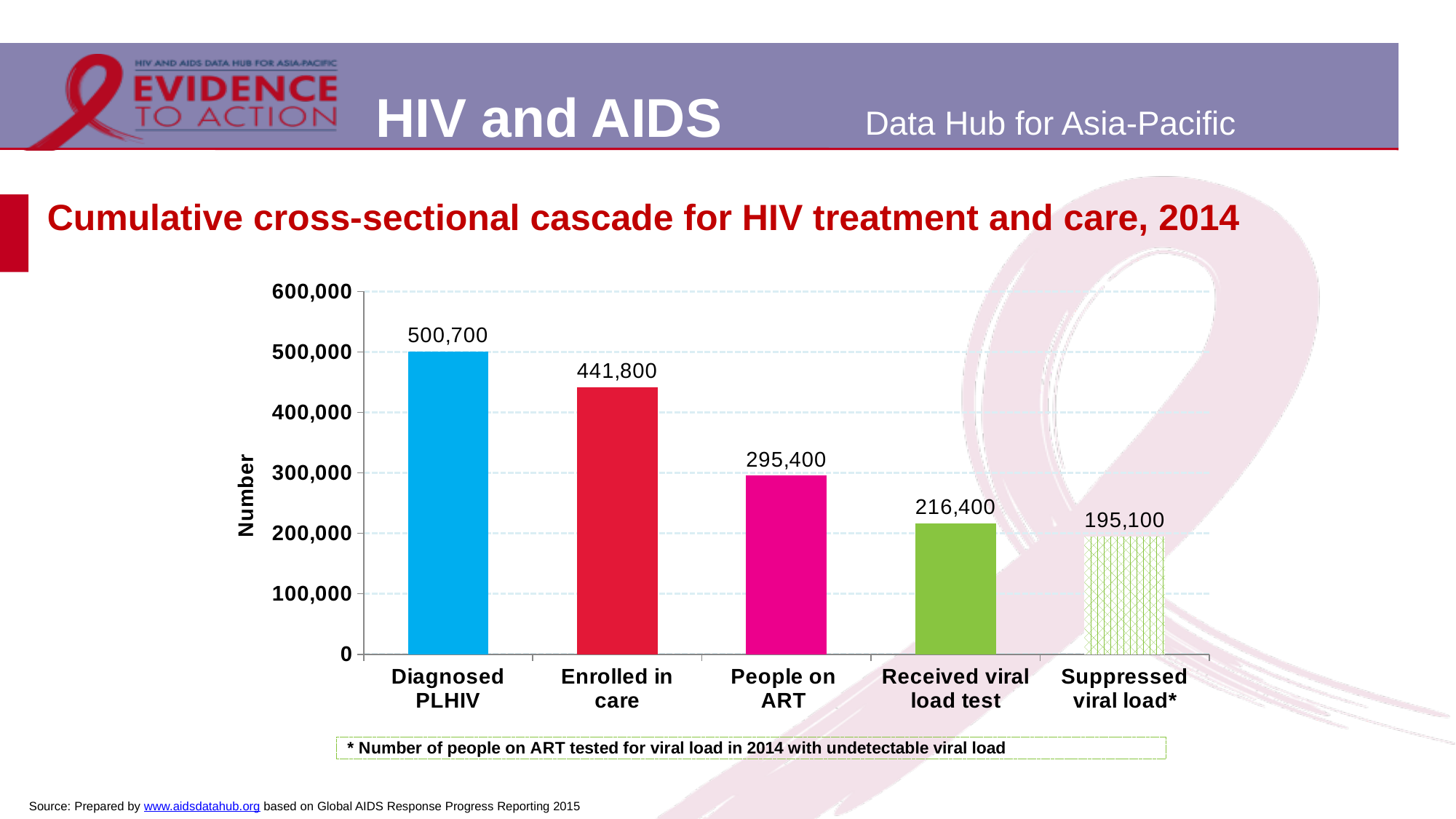
Which is larger, Enrolled in care or People on ART? Enrolled in care What is the value for People on ART? 295,400 What is the difference between People on ART and Received viral load test? 79,000 What is the value for Enrolled in care? 441,800 How many categories are shown on the x axis? 5 What is the value for Received viral load test? 216,400 What is the difference between Diagnosed PLHIV and Enrolled in care? 58,900 Which category has the lowest value? Suppressed viral load What is the value for Diagnosed PLHIV? 500,700 What is the value for Suppressed viral load? 195,100 Which category has the highest value? Diagnosed PLHIV What kind of chart is shown on the slide? Bar chart